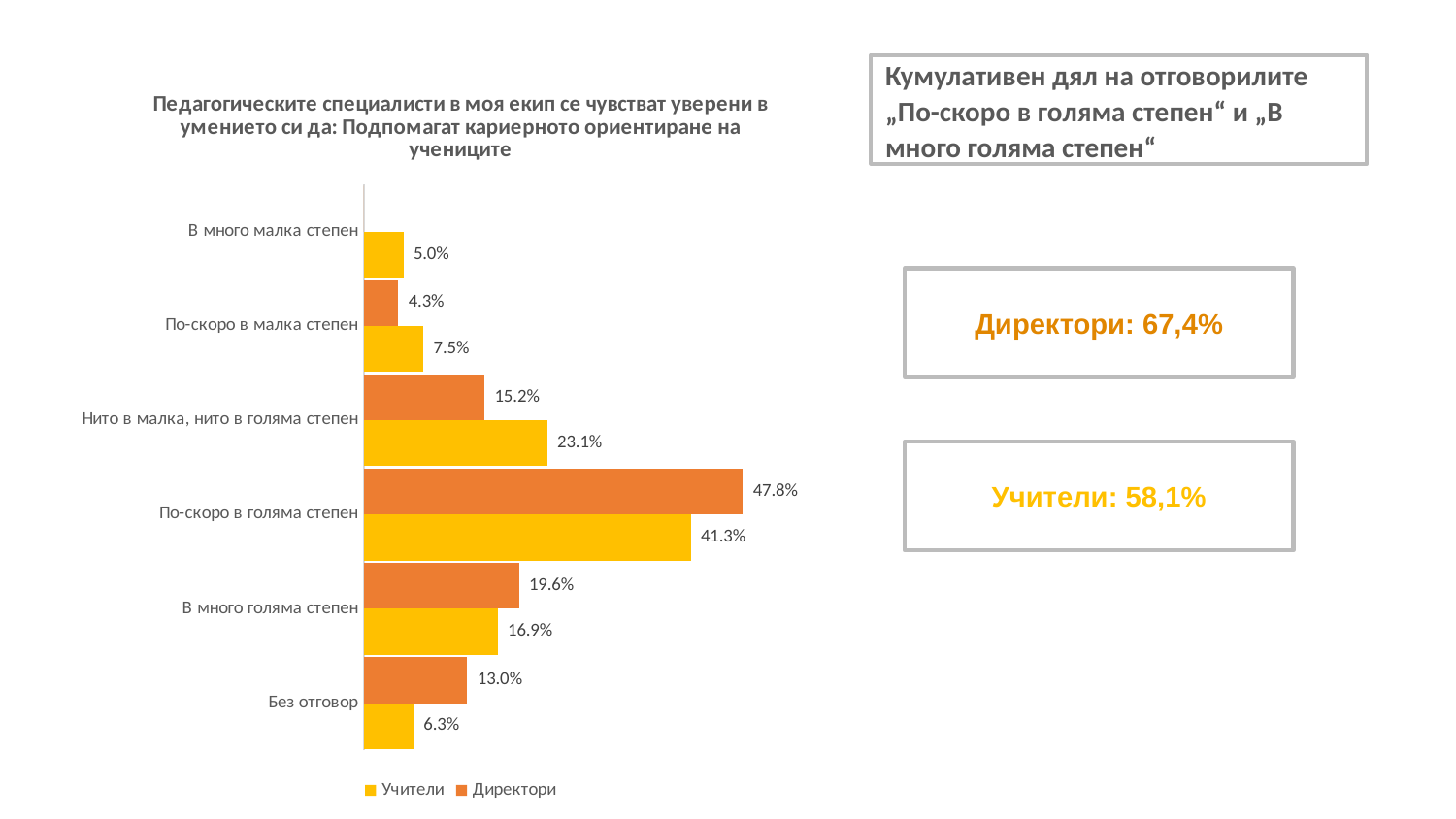
What is the value for Директори in the category "Нито в малка, нито в голяма степен"? 15.2% Which colour represents the Директори series in the chart? orange What is the difference between the Учители and Директори values in the category "Нито в малка, нито в голяма степен"? 7.9% In the category "В много голяма степен", which series has the larger value, Учители or Директори? Директори Which category has the highest value for Директори? По-скоро в голяма степен Which category has the lowest value for Учители? В много малка степен How many series does the chart legend list? 2 What is the value for Директори in the category "Без отговор"? 13.0% What kind of chart is shown on the slide? bar chart What is the value for Учители in the category "По-скоро в голяма степен"? 41.3% How many response categories are shown on the chart's vertical axis? 6 What is the difference between the Директори and Учители values in the category "По-скоро в голяма степен"? 6.5%